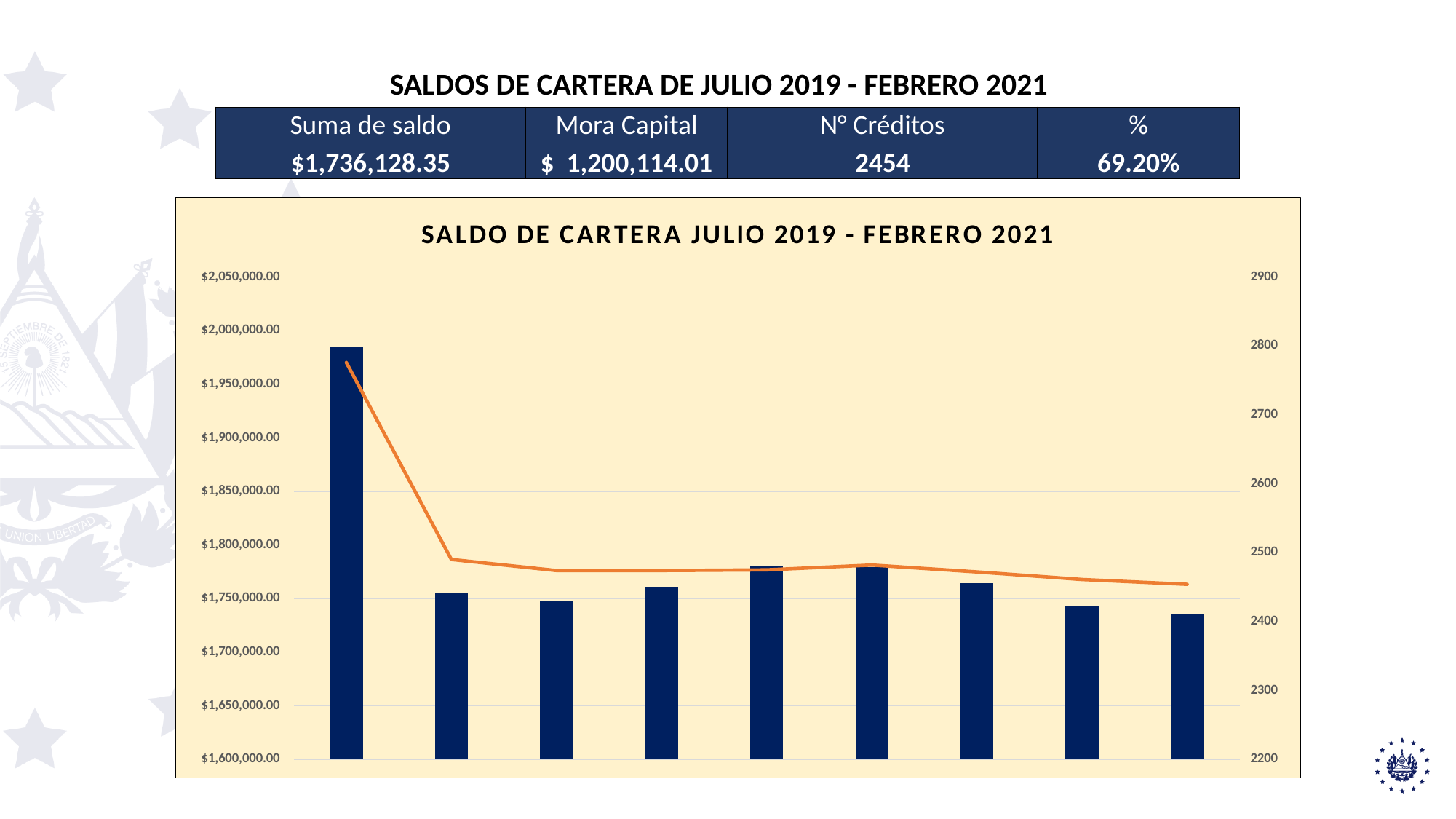
Is the first point of the orange line greater or less than 2700 on the right axis? greater Which is larger, the first bar or the second bar? the first bar How many bars are plotted in the chart? 9 Which bar in the chart is the highest? the first (leftmost) bar Which bar in the chart is the lowest? the last (rightmost) bar What kind of chart is shown on the slide? bar chart with a line Is the value of the first (leftmost) bar greater or less than $1,950,000.00? greater Is the last point of the orange line greater or less than 2500 on the right axis? less What is the title of the chart? SALDO DE CARTERA JULIO 2019 - FEBRERO 2021 Do the bar values overall rise or fall from left to right? fall Which is larger, the sixth bar or the ninth bar? the sixth bar